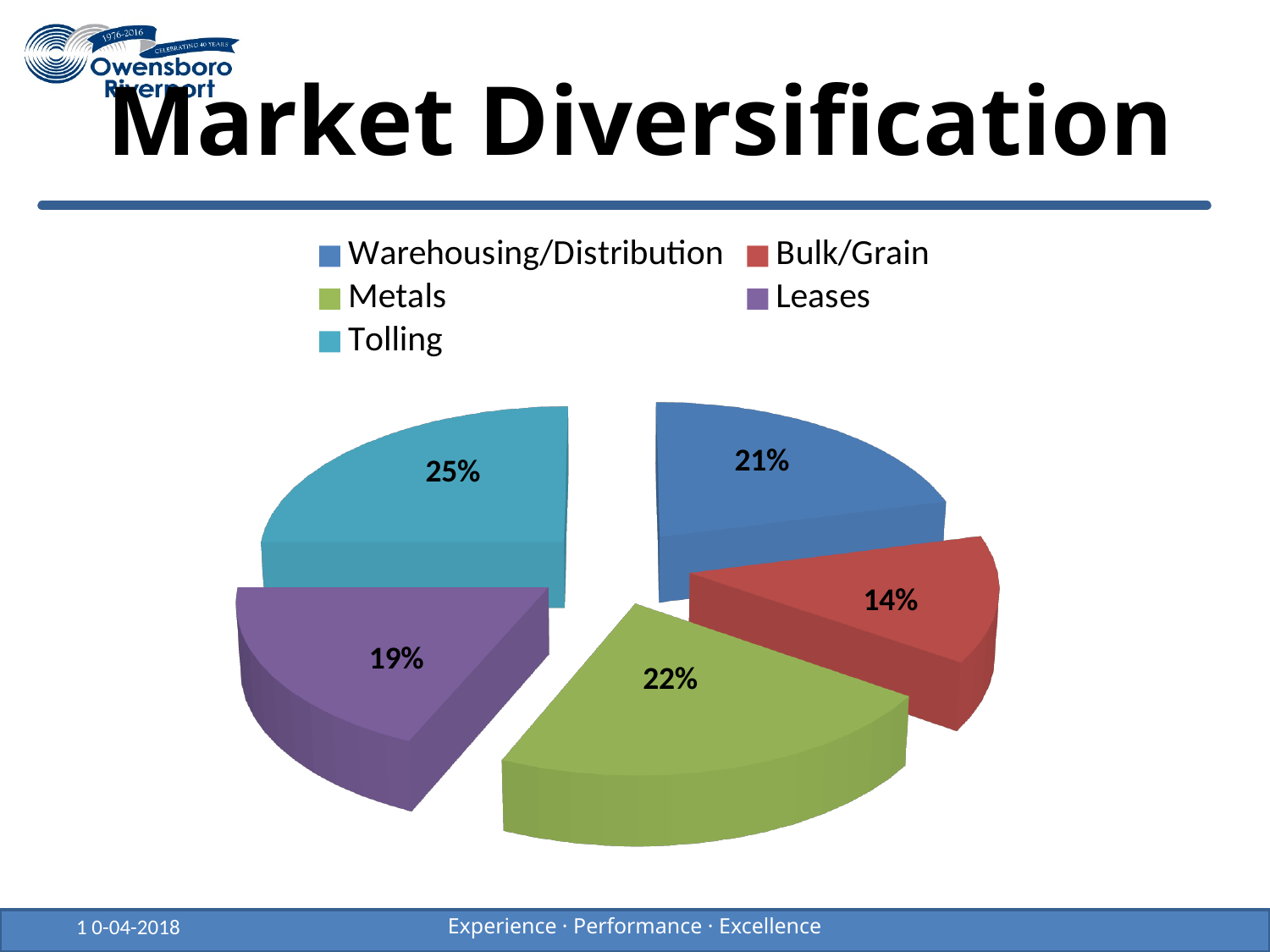
What share of the pie does Tolling represent? 25% Which category has the largest share of the pie? Tolling Which has a larger share, Metals or Leases? Metals What percentage is shown for Metals? 22% What percentage is shown for Bulk/Grain? 14% What percentage is shown for Warehousing/Distribution? 21% What percentage is shown for Leases? 19% What is the difference in percentage points between Tolling and Bulk/Grain? 11 How many categories are shown in the pie chart? 5 What is the title of the slide containing the chart? Market Diversification Which category has the smallest share of the pie? Bulk/Grain What type of chart is shown on the slide? Pie chart